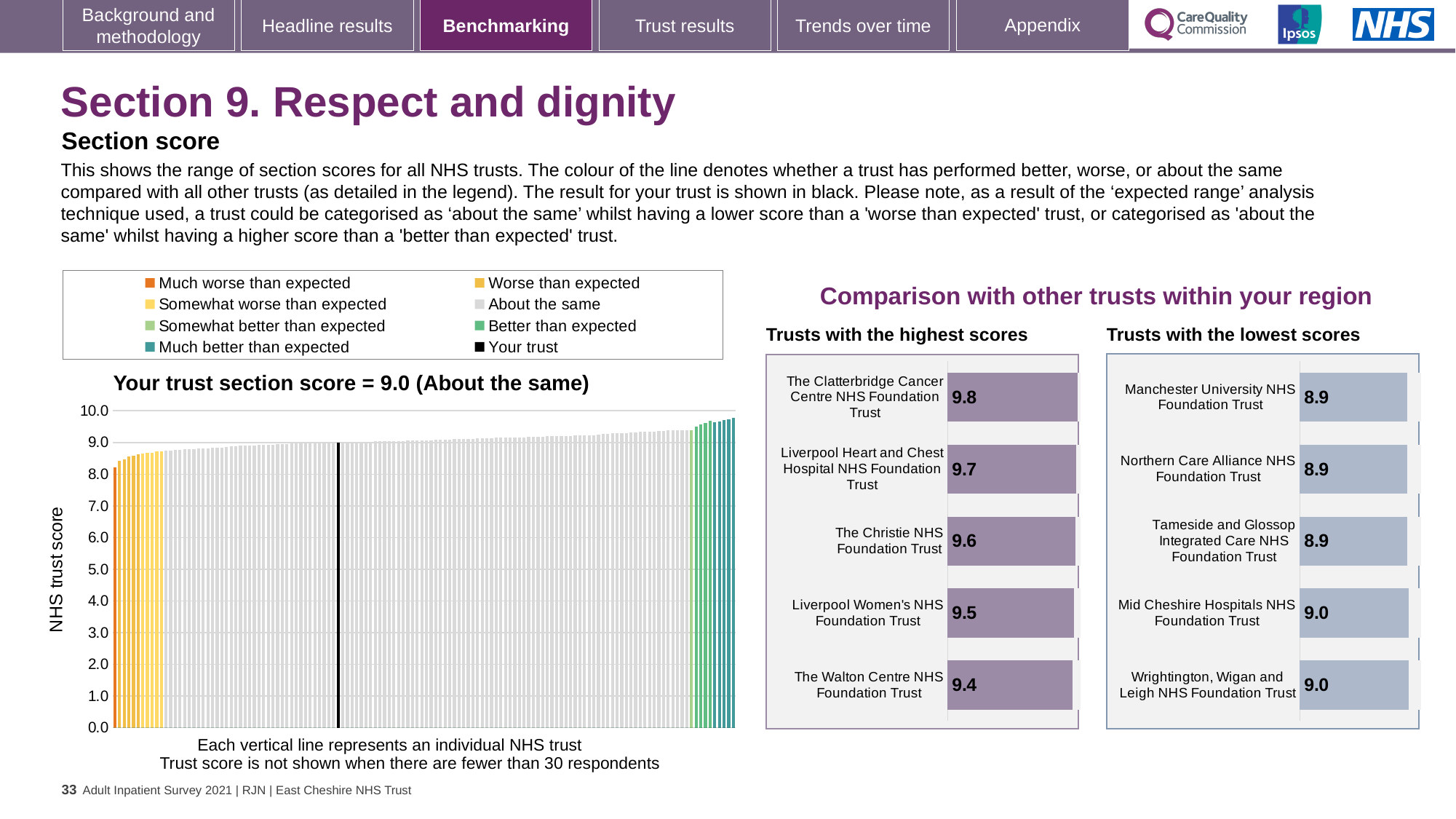
What kind of chart is the main chart on the left showing NHS trust scores? Bar chart In the 'Trusts with the lowest scores' chart, what is the score for Tameside and Glossop Integrated Care NHS Foundation Trust? 8.9 According to the title of the main chart on the left, what is your trust's section score? 9.0 In the 'Trusts with the highest scores' chart, what is the difference between the scores of The Clatterbridge Cancer Centre NHS Foundation Trust and The Walton Centre NHS Foundation Trust? 0.4 In the 'Trusts with the lowest scores' chart, what is the score for Mid Cheshire Hospitals NHS Foundation Trust? 9.0 In the 'Trusts with the lowest scores' chart, which has the larger score: Mid Cheshire Hospitals NHS Foundation Trust or Manchester University NHS Foundation Trust? Mid Cheshire Hospitals NHS Foundation Trust In the 'Trusts with the highest scores' chart, what is the score for The Clatterbridge Cancer Centre NHS Foundation Trust? 9.8 In the main chart on the left, is the lowest trust score greater or less than 9.0? less In the 'Trusts with the highest scores' chart, which trust has the highest score? The Clatterbridge Cancer Centre NHS Foundation Trust In the 'Trusts with the highest scores' chart, what is the score for The Walton Centre NHS Foundation Trust? 9.4 In the 'Trusts with the lowest scores' chart, what is the difference between the scores of Wrightington, Wigan and Leigh NHS Foundation Trust and Northern Care Alliance NHS Foundation Trust? 0.1 How many trusts are shown in the 'Trusts with the highest scores' chart? 5